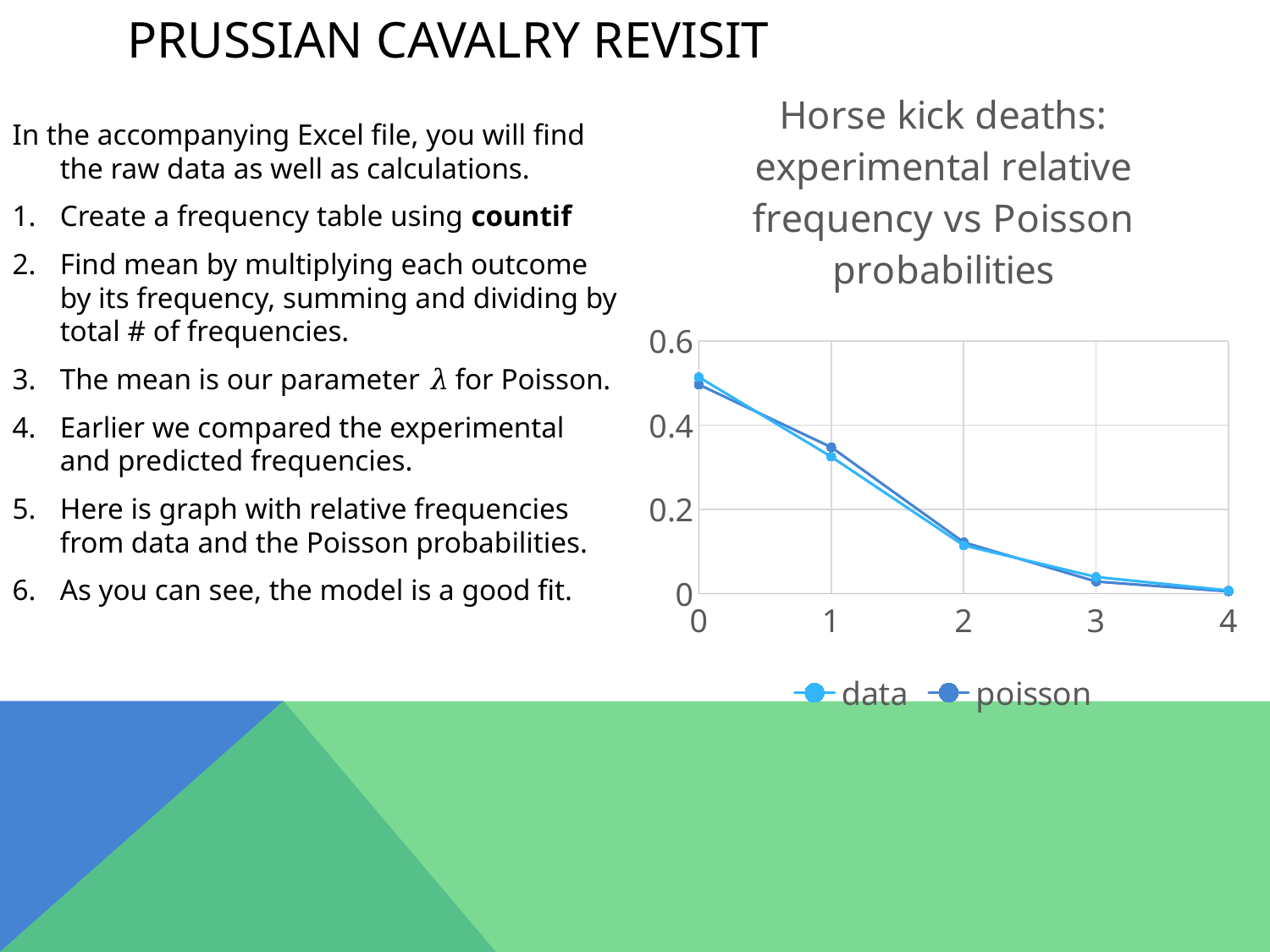
Which is larger for the poisson series: the value at x = 1 or the value at x = 3? x = 1 What is the title of the chart? Horse kick deaths: experimental relative frequency vs Poisson probabilities Is the value of the poisson series at x = 2 greater or less than 0.2? less How many points are plotted for the data series along the x axis? 5 How many series does the chart's legend list? 2 At which x value is the poisson series highest? 0 Is the value of the data series at x = 1 greater or less than 0.2? greater Is the value of the data series at x = 0 greater or less than 0.4? greater What kind of chart is shown on the slide? line chart Do the values of the data series rise or fall as x increases from 0 to 4? fall At which x value is the data series lowest? 4 What are the names of the two series in the chart's legend? data and poisson